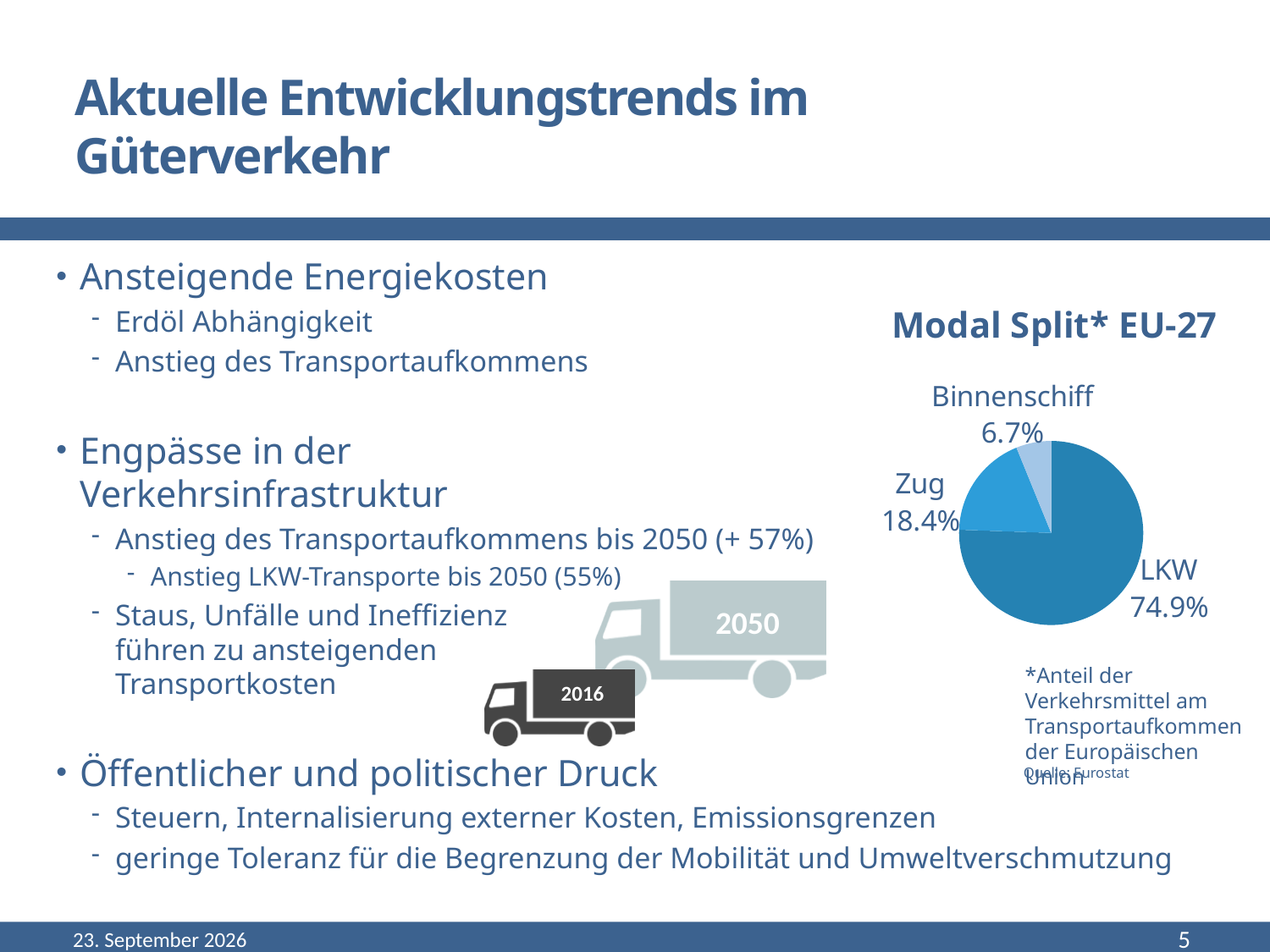
Which category has the smallest slice in the Modal Split* EU-27 pie chart? Binnenschiff How many slices does the Modal Split* EU-27 pie chart have? 3 What is the title of the pie chart on the slide? Modal Split* EU-27 What is the share of LKW in the Modal Split* EU-27 pie chart? 74.9% In the Modal Split* EU-27 pie chart, what is the difference in percentage points between LKW and Zug? 56.5 In the Modal Split* EU-27 pie chart, what is the difference in percentage points between Zug and Binnenschiff? 11.7 What type of chart is shown under the title "Modal Split* EU-27"? pie chart What is the share of Zug in the Modal Split* EU-27 pie chart? 18.4% Which category has the largest slice in the Modal Split* EU-27 pie chart? LKW What is the share of Binnenschiff in the Modal Split* EU-27 pie chart? 6.7% What source is cited below the Modal Split* EU-27 pie chart? Eurostat In the Modal Split* EU-27 pie chart, which is larger: Zug or Binnenschiff? Zug